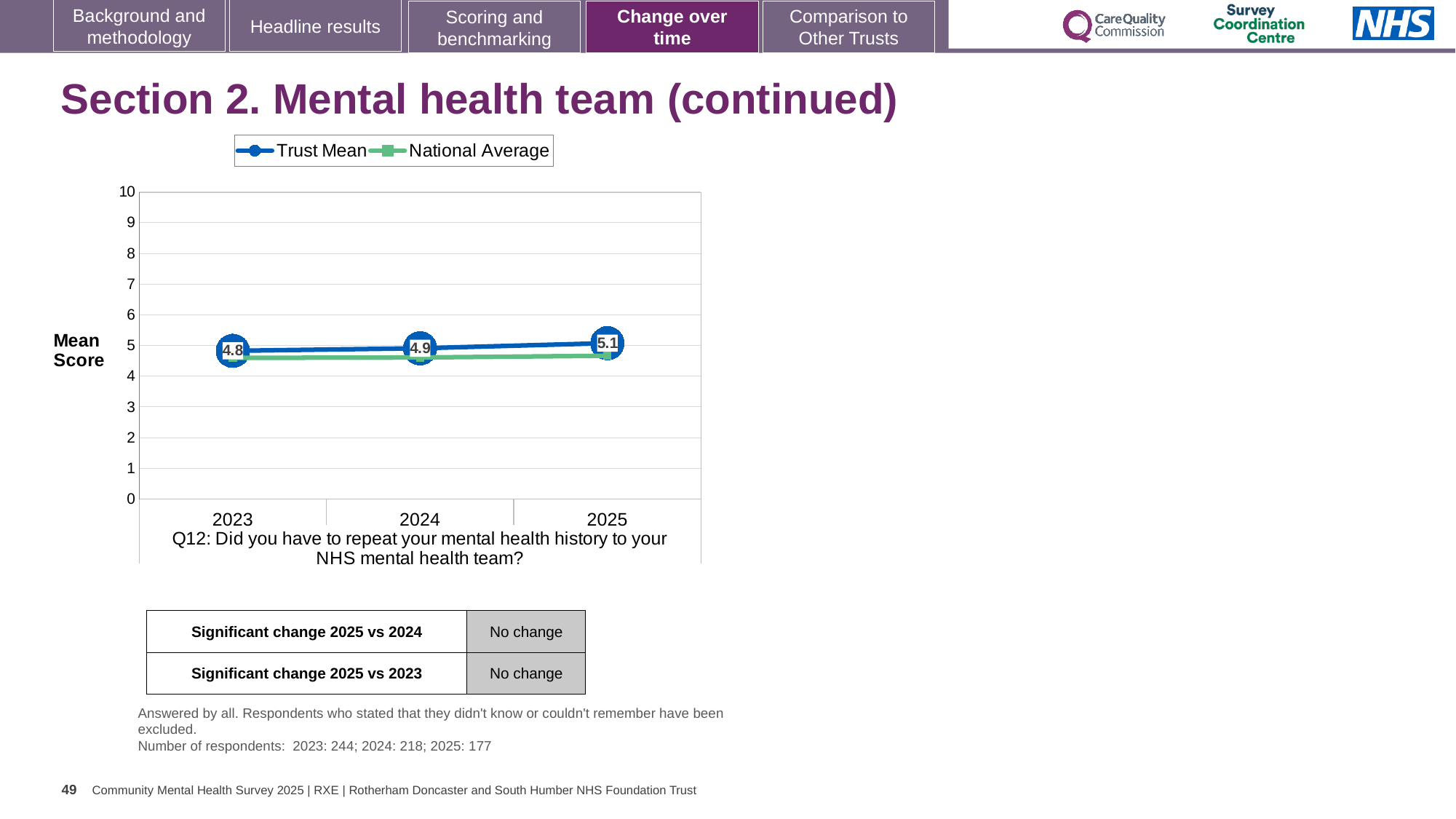
How many years are shown on the x axis of the chart? 3 What kind of chart is shown on the slide? line chart What is the difference between the Trust Mean score in 2025 and in 2023? 0.3 What is the Trust Mean score for 2023? 4.8 How many series does the chart legend list? 2 In which year is the Trust Mean score highest? 2025 What is the Trust Mean score for 2025? 5.1 In which year is the Trust Mean score lowest? 2023 What is the Trust Mean score for 2024? 4.9 In 2025, which is higher: the Trust Mean or the National Average? Trust Mean Is the National Average value for 2023 greater or less than 5? less Does the Trust Mean score rise or fall from 2023 to 2025? rise